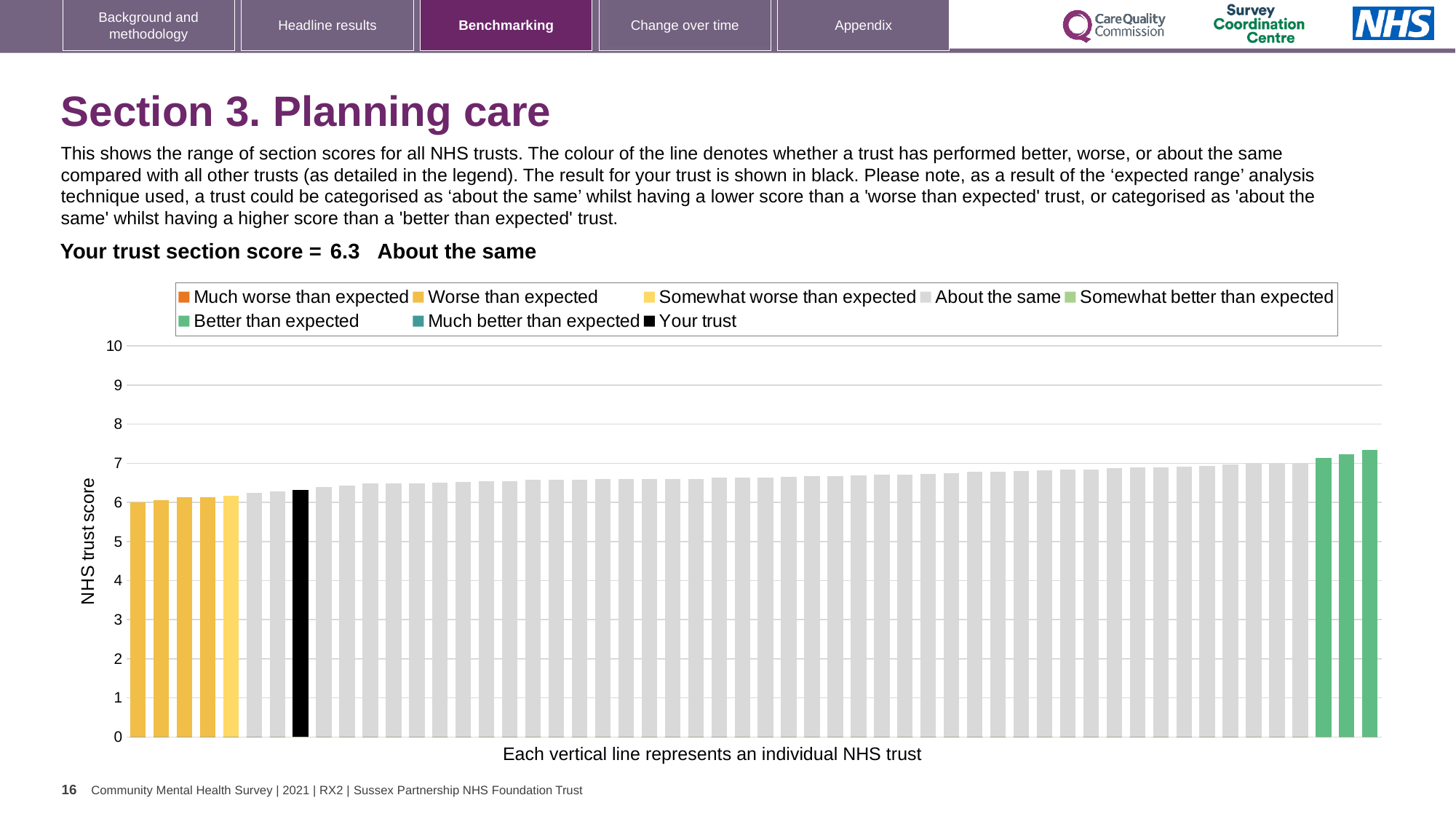
What kind of chart is shown on the slide? bar chart Is the shortest bar in the chart greater or less than 5? greater Is the tallest bar in the chart greater or less than 7? greater Which category is your trust placed in for this section? About the same Is the value of the black 'Your trust' bar greater or less than 5? greater What is the label on the vertical axis of the chart? NHS trust score Which is larger: the black 'Your trust' bar or the rightmost green bar? the rightmost green bar How many entries does the chart legend list? 8 How many bars are coloured green ('Better than expected')? 3 What is the section score for your trust shown on the slide? 6.3 Do the bar values rise or fall from left to right along the x axis? rise